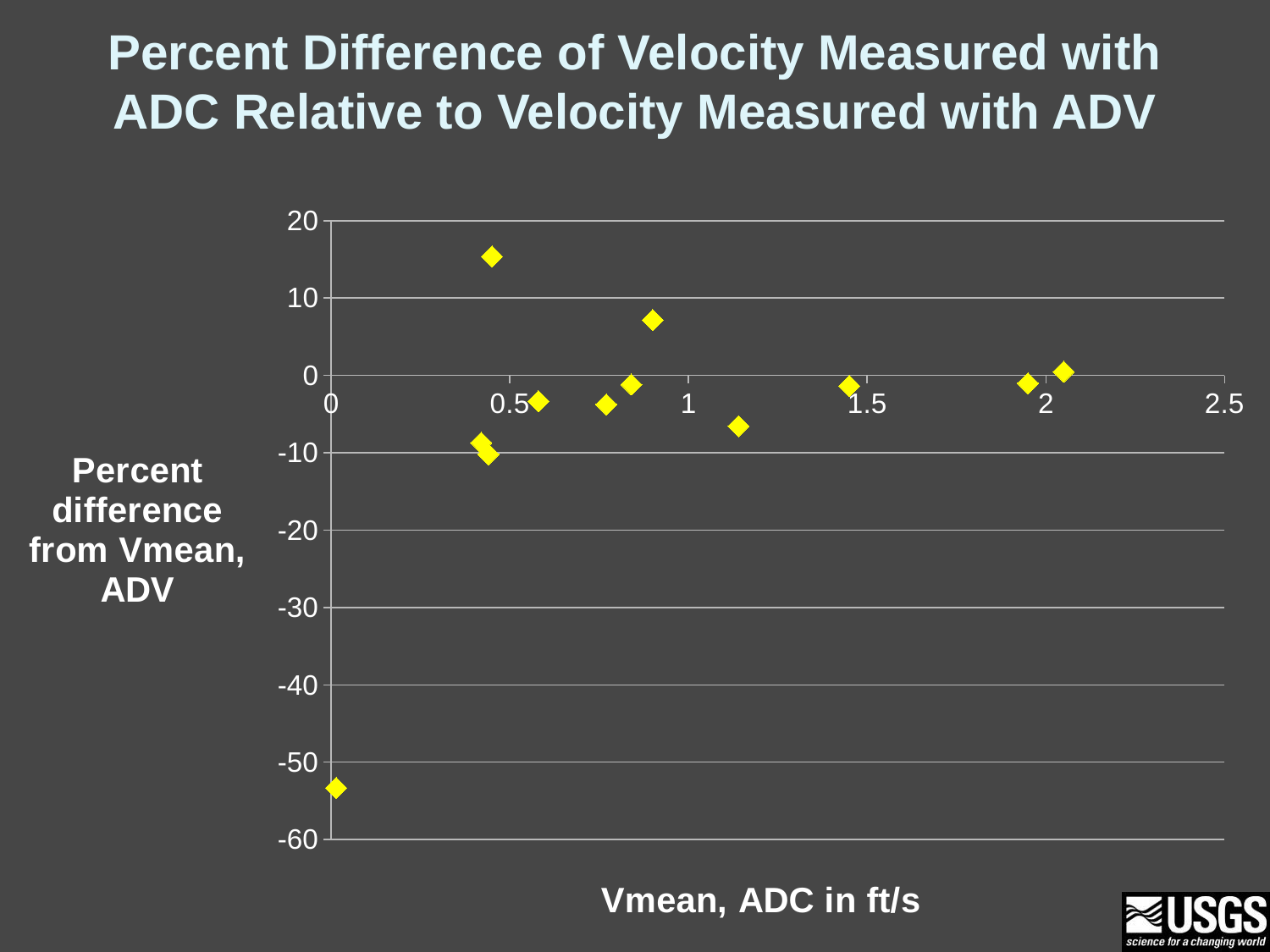
Is the highest point on the chart greater or less than 10? greater Which has the lower percent difference: the point near Vmean 0 ft/s or the point near Vmean 2 ft/s? the point near 0 ft/s Is the lowest point on the chart greater or less than -50? less What kind of chart is shown on the slide? scatter chart Is the percent difference for the point near Vmean 0.9 ft/s greater or less than 0? greater What is the title of the chart? Percent Difference of Velocity Measured with ADC Relative to Velocity Measured with ADV What is the label of the x axis? Vmean, ADC in ft/s Which has the larger percent difference: the point near Vmean 0.45 ft/s at the top of the chart or the point near Vmean 0.9 ft/s? the point near 0.45 ft/s What is the minimum value shown on the y axis? -60